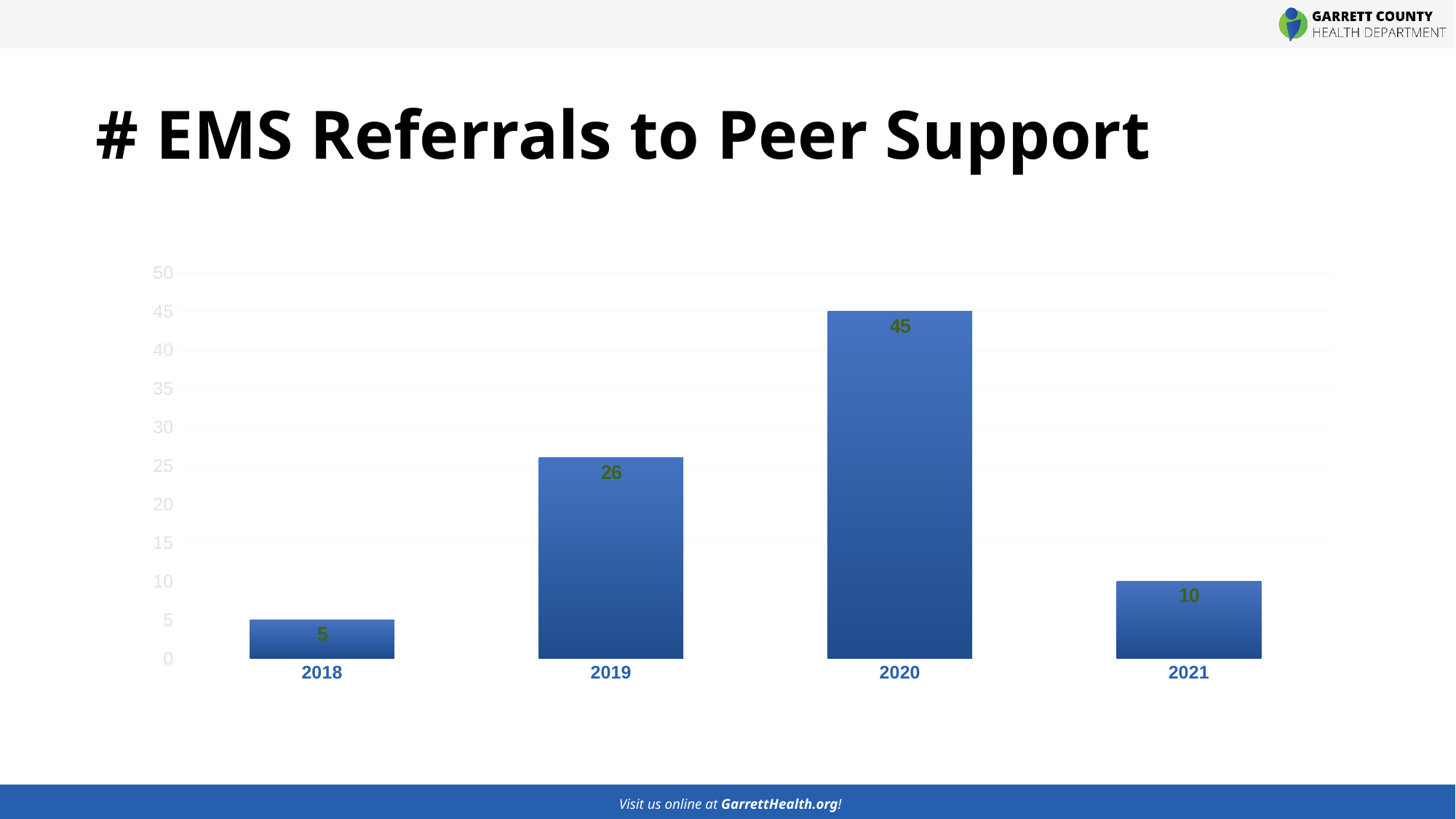
What kind of chart is shown on the slide? Bar chart What is the number of EMS referrals to peer support in 2021? 10 How many years are shown on the chart? 4 What is the title of the slide? # EMS Referrals to Peer Support Which year had more EMS referrals to peer support, 2019 or 2021? 2019 Which year has the highest number of EMS referrals to peer support? 2020 What is the number of EMS referrals to peer support in 2020? 45 What is the number of EMS referrals to peer support in 2018? 5 What is the difference between the number of referrals in 2021 and in 2018? 5 What is the difference between the number of referrals in 2020 and in 2019? 19 Is the value for 2019 greater or less than 20? greater Which year has the lowest number of EMS referrals to peer support? 2018